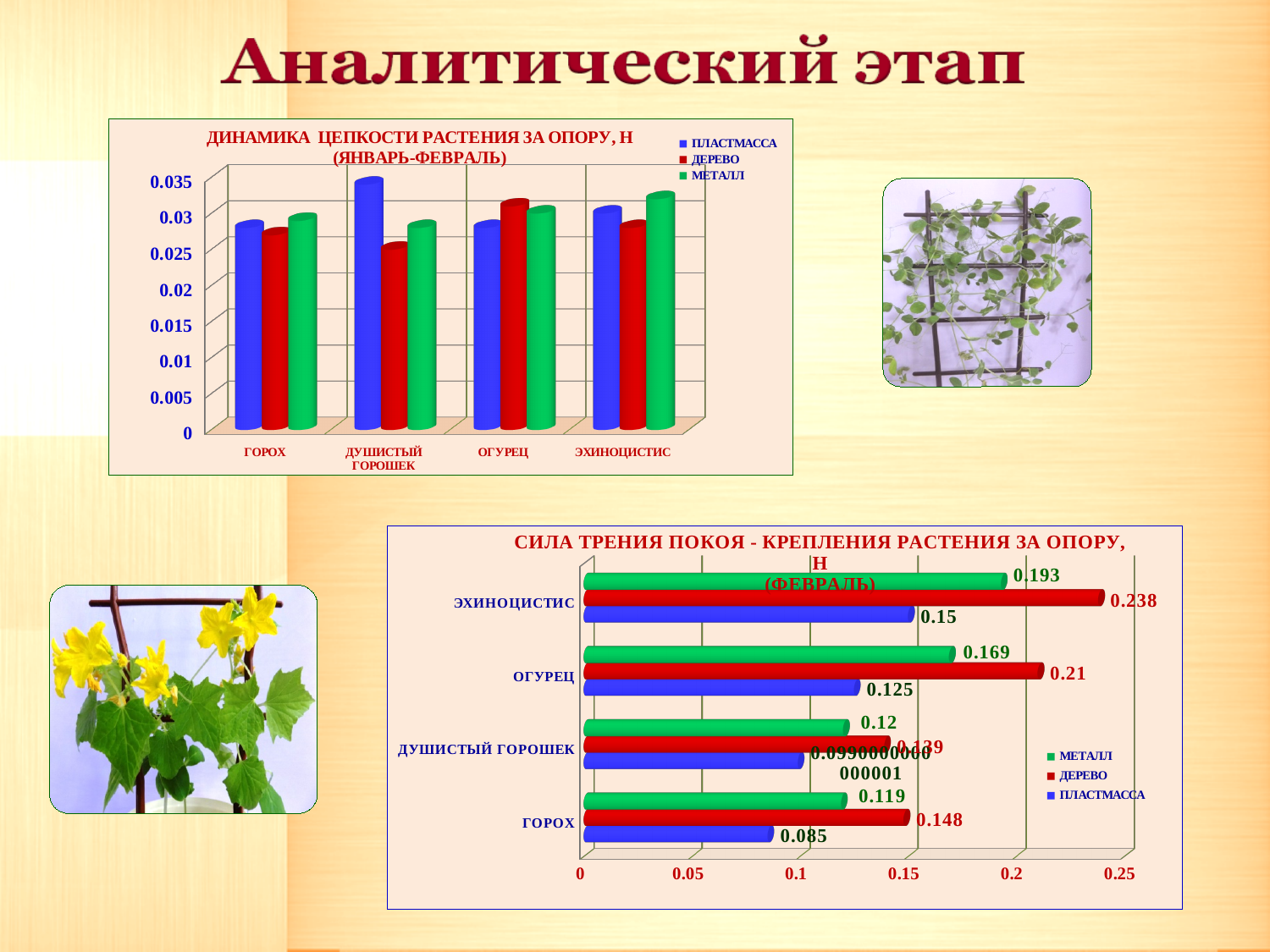
In the bottom chart (СИЛА ТРЕНИЯ ПОКОЯ), which is larger for ГОРОХ: the МЕТАЛЛ value or the ДЕРЕВО value? ДЕРЕВО What kind of chart is the bottom chart (СИЛА ТРЕНИЯ ПОКОЯ)? Bar chart In the bottom chart (СИЛА ТРЕНИЯ ПОКОЯ), which plant has the lowest value for ПЛАСТМАССА? ГОРОХ In the bottom chart (СИЛА ТРЕНИЯ ПОКОЯ), what is the value for МЕТАЛЛ for ОГУРЕЦ? 0.169 In the top chart (ДИНАМИКА ЦЕПКОСТИ РАСТЕНИЯ ЗА ОПОРУ), is the ПЛАСТМАССА value for ДУШИСТЫЙ ГОРОШЕК greater or less than 0.03? greater In the bottom chart (СИЛА ТРЕНИЯ ПОКОЯ), what is the value for ПЛАСТМАССА for ГОРОХ? 0.085 In the top chart (ДИНАМИКА ЦЕПКОСТИ РАСТЕНИЯ ЗА ОПОРУ), which colour represents МЕТАЛЛ in the legend? Green In the bottom chart (СИЛА ТРЕНИЯ ПОКОЯ), what is the difference between the ДЕРЕВО and ПЛАСТМАССА values for ОГУРЕЦ? 0.085 In the bottom chart (СИЛА ТРЕНИЯ ПОКОЯ), what is the value for ДЕРЕВО for ЭХИНОЦИСТИС? 0.238 In the bottom chart (СИЛА ТРЕНИЯ ПОКОЯ), which plant has the highest value for ДЕРЕВО? ЭХИНОЦИСТИС In the bottom chart (СИЛА ТРЕНИЯ ПОКОЯ), how many series does the legend list? 3 In the top chart (ДИНАМИКА ЦЕПКОСТИ РАСТЕНИЯ ЗА ОПОРУ), how many plant categories are shown on the x axis? 4